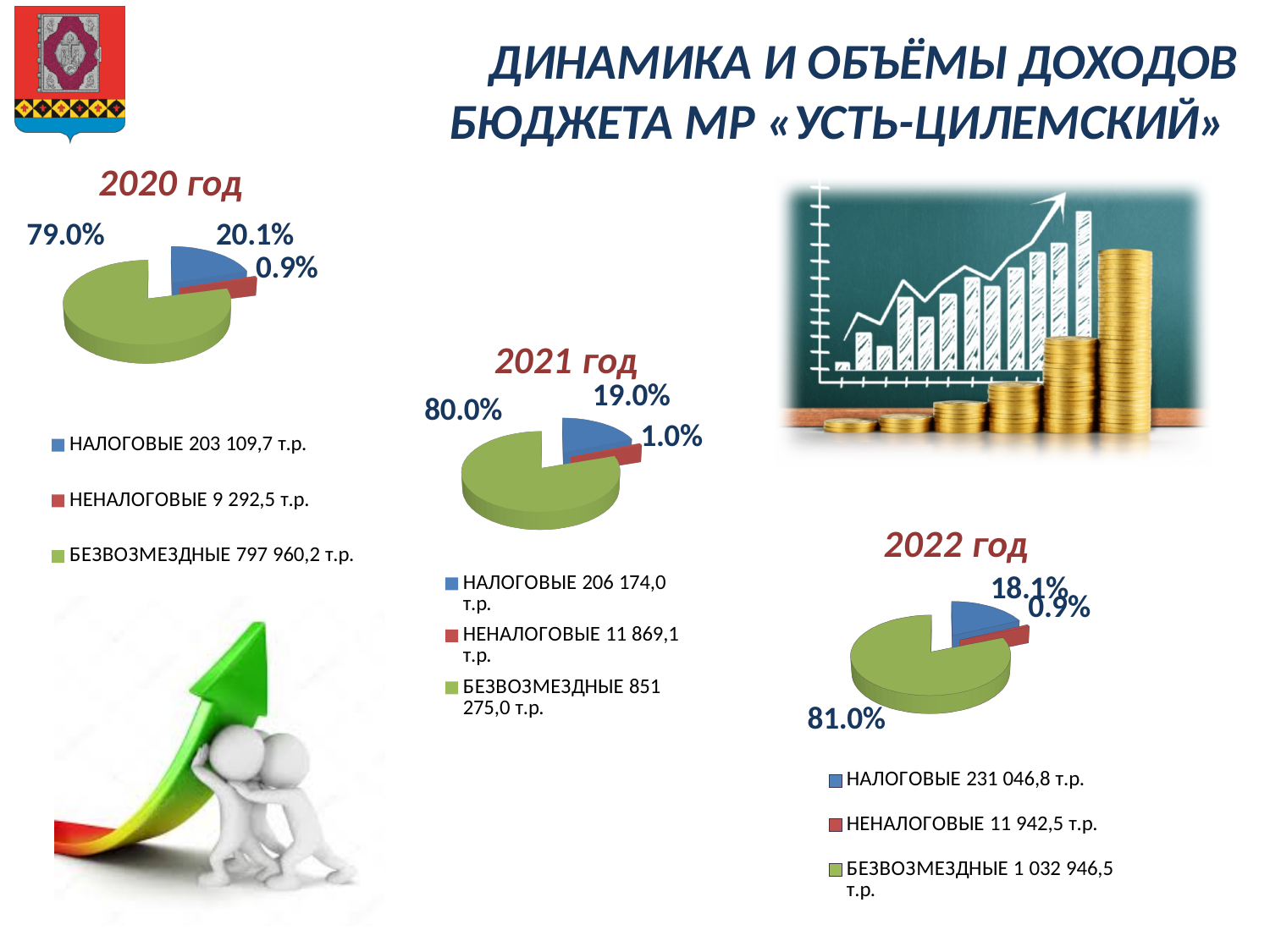
In the "2020 год" chart, which slice is larger: НАЛОГОВЫЕ or НЕНАЛОГОВЫЕ? НАЛОГОВЫЕ In the "2020 год" chart, what share of the pie is labelled for the БЕЗВОЗМЕЗДНЫЕ slice? 79.0% In the "2021 год" chart, which category has the smallest slice? НЕНАЛОГОВЫЕ In the "2021 год" chart legend, what value is given for НАЛОГОВЫЕ? 206 174,0 т.р. In the "2022 год" chart, which category has the largest slice? БЕЗВОЗМЕЗДНЫЕ In the "2021 год" chart, what percentage is shown for the НЕНАЛОГОВЫЕ slice? 1.0% How many entries does the legend of the "2022 год" chart list? 3 What type of chart is used for "2021 год"? Pie chart In the "2020 год" chart, what percentage is shown for the НАЛОГОВЫЕ slice? 20.1% In the "2022 год" chart, what share of the pie does the БЕЗВОЗМЕЗДНЫЕ slice have? 81.0% How many slices does the "2020 год" pie chart have? 3 In the "2022 год" chart, what is the difference in percentage points between the БЕЗВОЗМЕЗДНЫЕ and НАЛОГОВЫЕ slices? 62.9